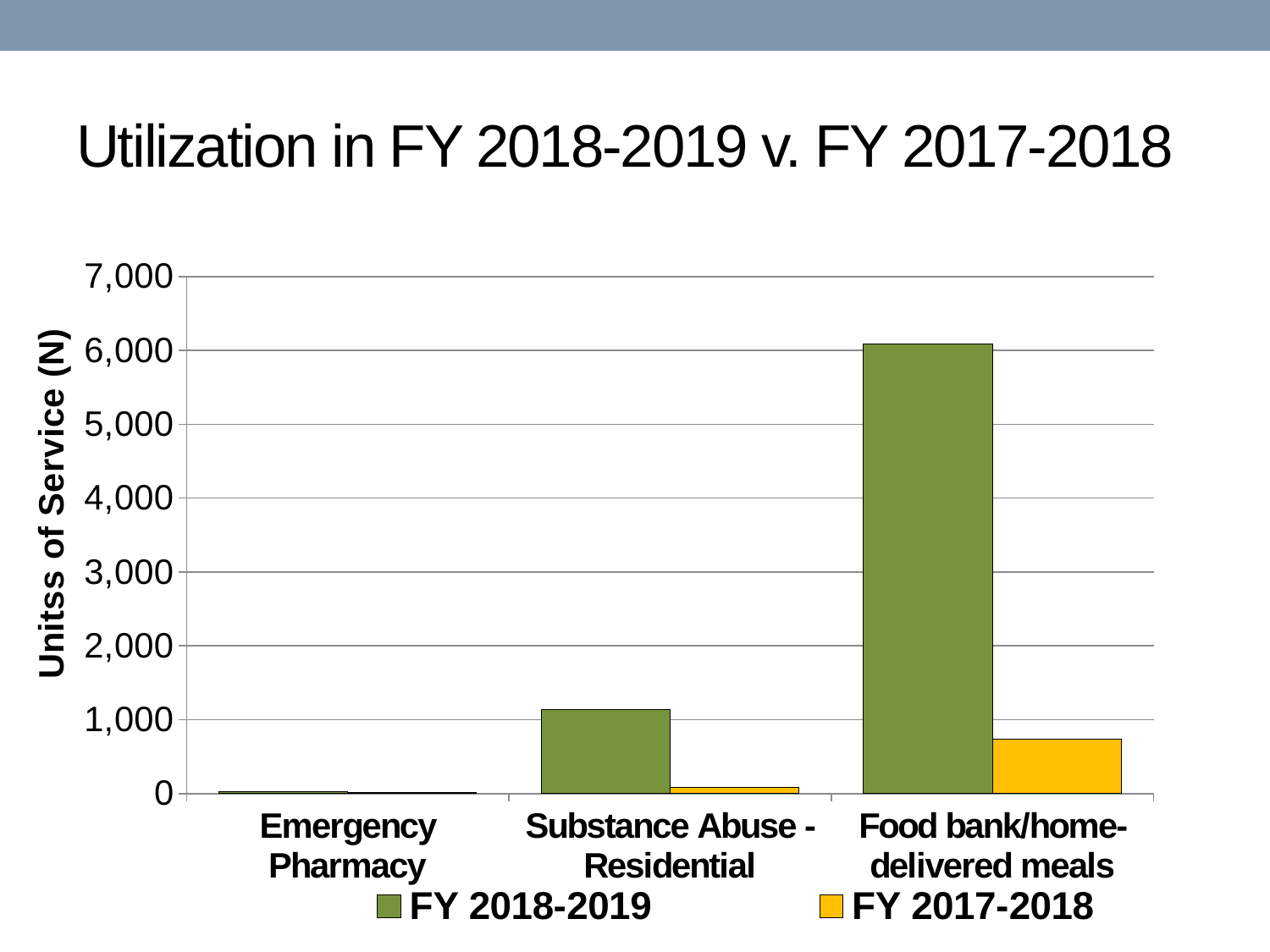
How many series does the legend list? 2 Is the FY 2018-2019 value for Substance Abuse - Residential greater or less than 1,000? greater Which category has the highest FY 2018-2019 value? Food bank/home-delivered meals What is the label of the y axis? Unitss of Service (N) Is the FY 2018-2019 value for Food bank/home-delivered meals greater or less than 6,000? greater Which category has the highest FY 2017-2018 value? Food bank/home-delivered meals For Substance Abuse - Residential, which is larger: the FY 2018-2019 value or the FY 2017-2018 value? FY 2018-2019 Is the FY 2017-2018 value for Food bank/home-delivered meals greater or less than 1,000? less Which category has the lowest FY 2018-2019 value? Emergency Pharmacy What is the title of the chart? Utilization in FY 2018-2019 v. FY 2017-2018 What kind of chart is shown on the slide? bar chart How many categories are shown on the x axis? 3